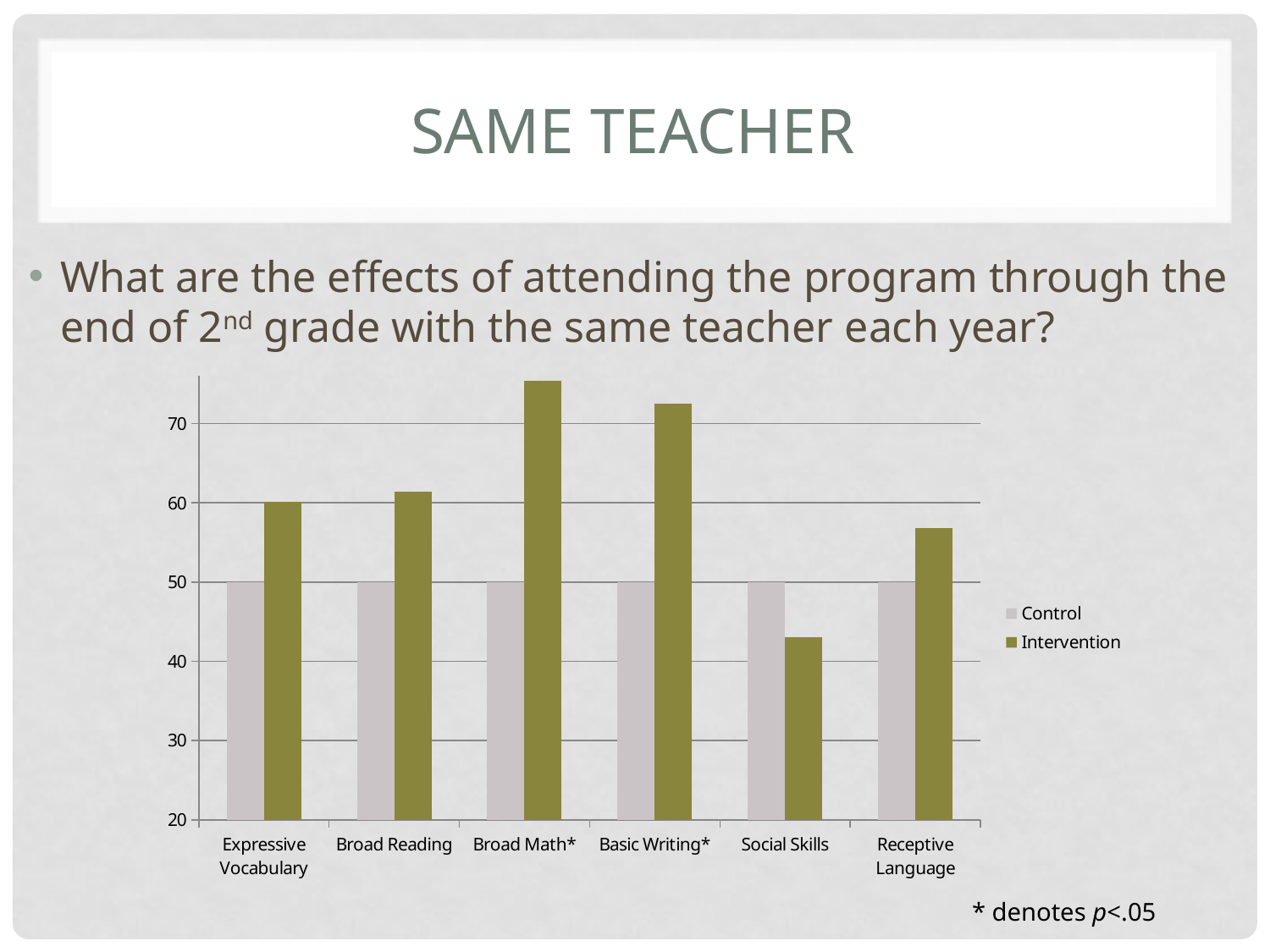
Which category has the lowest Intervention value? Social Skills Which has the larger Intervention value, Basic Writing* or Receptive Language? Basic Writing* Which category has the highest Intervention value? Broad Math* Is the Intervention value for Social Skills greater or less than 50? less Is the Intervention value for Broad Math* greater or less than 70? greater How many series does the legend list? 2 What are the two entries in the chart legend? Control and Intervention For Social Skills, which series has the larger value, Control or Intervention? Control What is the Control value for Broad Reading? 50 What kind of chart is shown on the slide? Bar chart Is the Intervention value for Receptive Language greater or less than 50? greater How many categories are shown on the x axis? 6